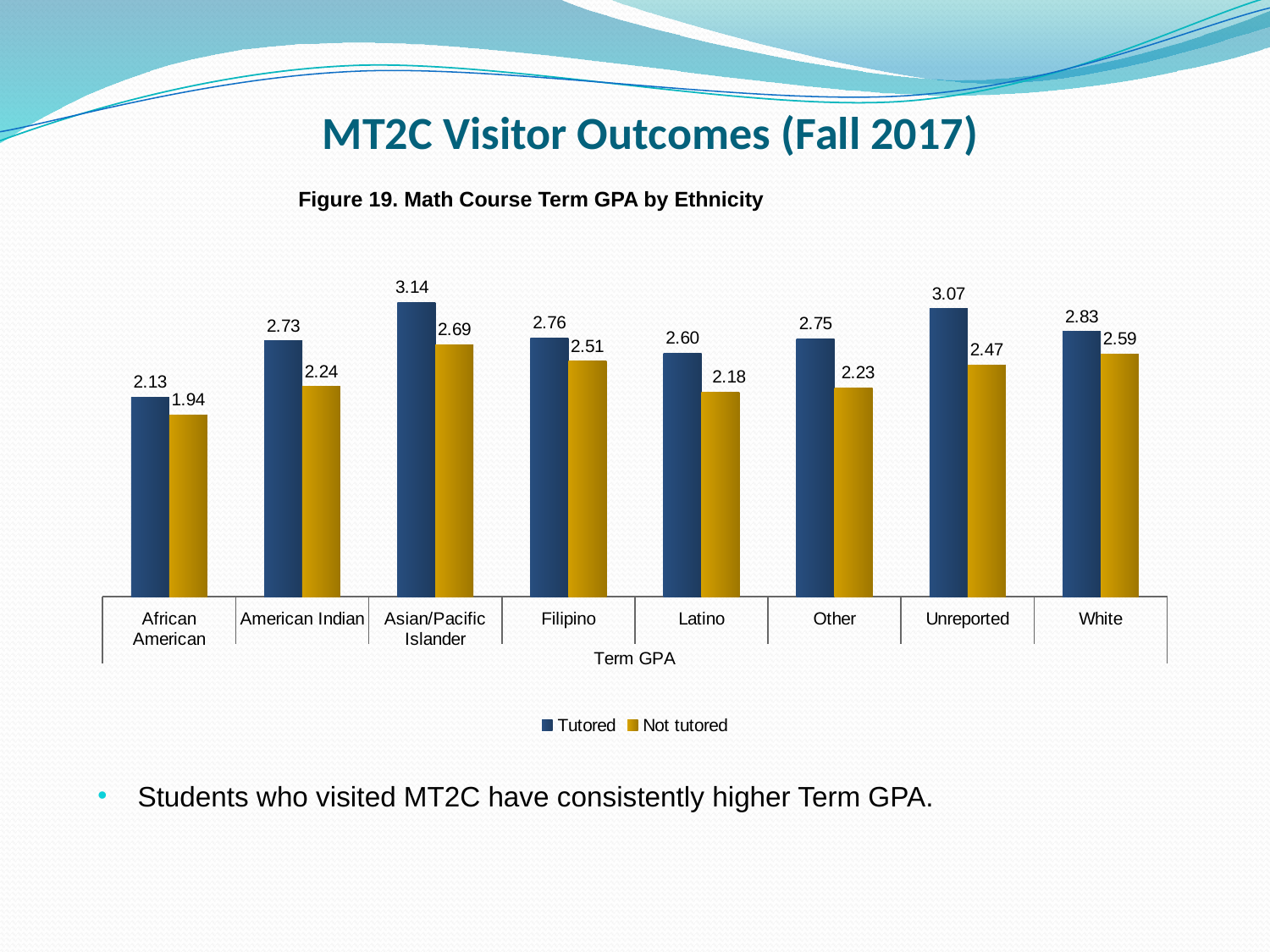
What is the Tutored Term GPA for Unreported students? 3.07 How many series does the legend list? 2 What is the Tutored Term GPA for Asian/Pacific Islander students? 3.14 How many ethnicity categories are shown on the x axis? 8 Which is larger, the Not tutored Term GPA for White students or for Filipino students? White Which ethnicity has the lowest Not tutored Term GPA? African American Which ethnicity has the highest Tutored Term GPA? Asian/Pacific Islander What is the title of the figure shown on the slide? Figure 19. Math Course Term GPA by Ethnicity What is the Not tutored Term GPA for Latino students? 2.18 What is the difference between the Tutored and Not tutored Term GPA for Unreported students? 0.60 Which series is shown in dark blue in the legend? Tutored What kind of chart is shown on the slide? Bar chart